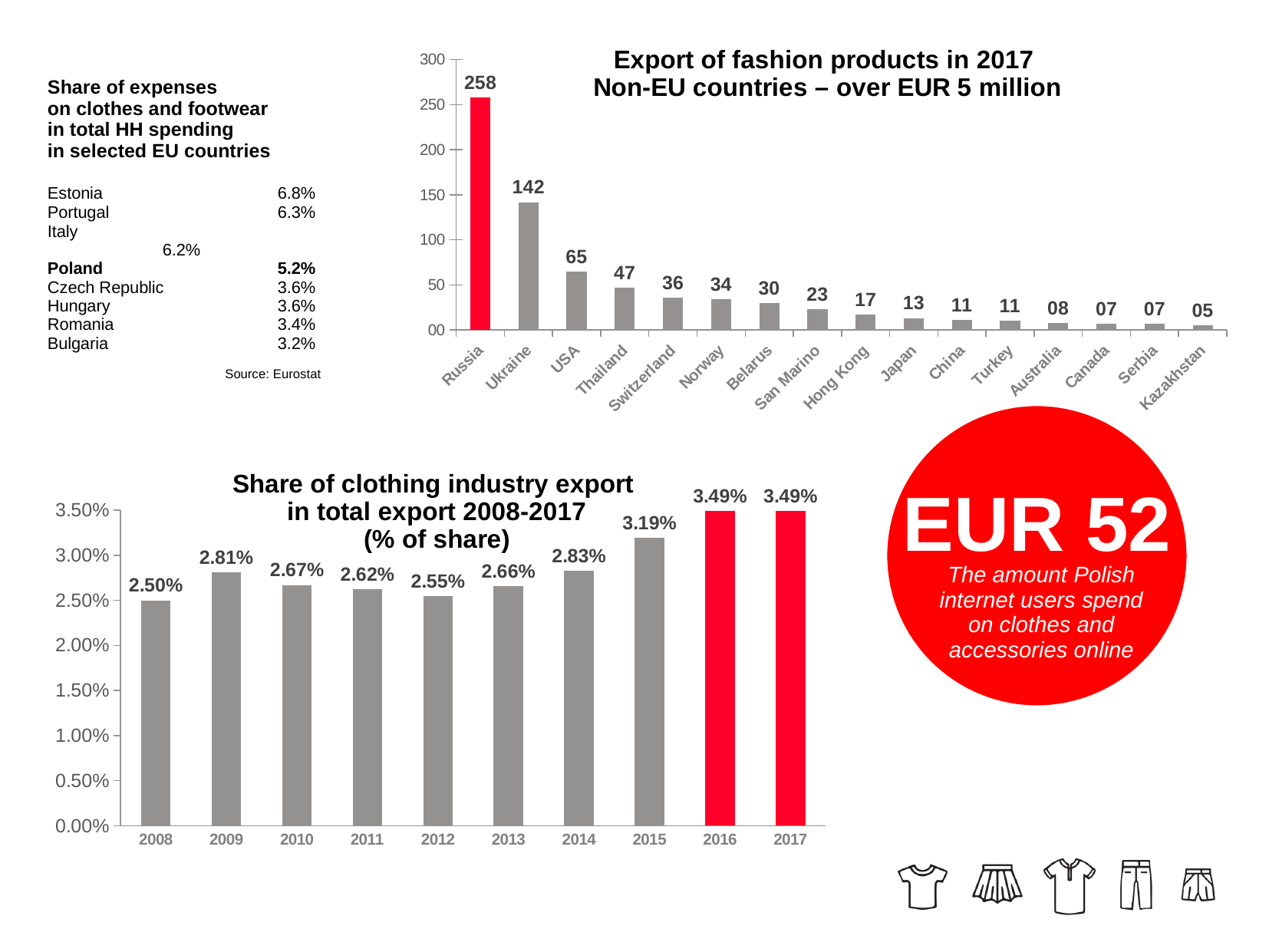
In the 'Export of fashion products in 2017' chart, what is the value for Ukraine? 142 In the 'Export of fashion products in 2017' chart, what is the value for Switzerland? 36 In the 'Export of fashion products in 2017' chart, what is the difference between the values for Russia and Ukraine? 116 What kind of chart is the 'Share of clothing industry export in total export 2008-2017' chart? Bar chart In the 'Share of clothing industry export in total export 2008-2017' chart, how many years are shown? 10 In the 'Export of fashion products in 2017' chart, which country has the highest value? Russia In the 'Share of clothing industry export in total export 2008-2017' chart, what is the value for 2015? 3.19% In the 'Export of fashion products in 2017' chart, which country has the lowest value? Kazakhstan In the 'Export of fashion products in 2017' chart, how many countries are shown? 16 In the 'Share of clothing industry export in total export 2008-2017' chart, what is the difference between the values for 2017 and 2008? 0.99% In the 'Share of clothing industry export in total export 2008-2017' chart, which year has the lowest value? 2008 In the 'Export of fashion products in 2017' chart, which is larger, the value for Thailand or the value for Norway? Thailand